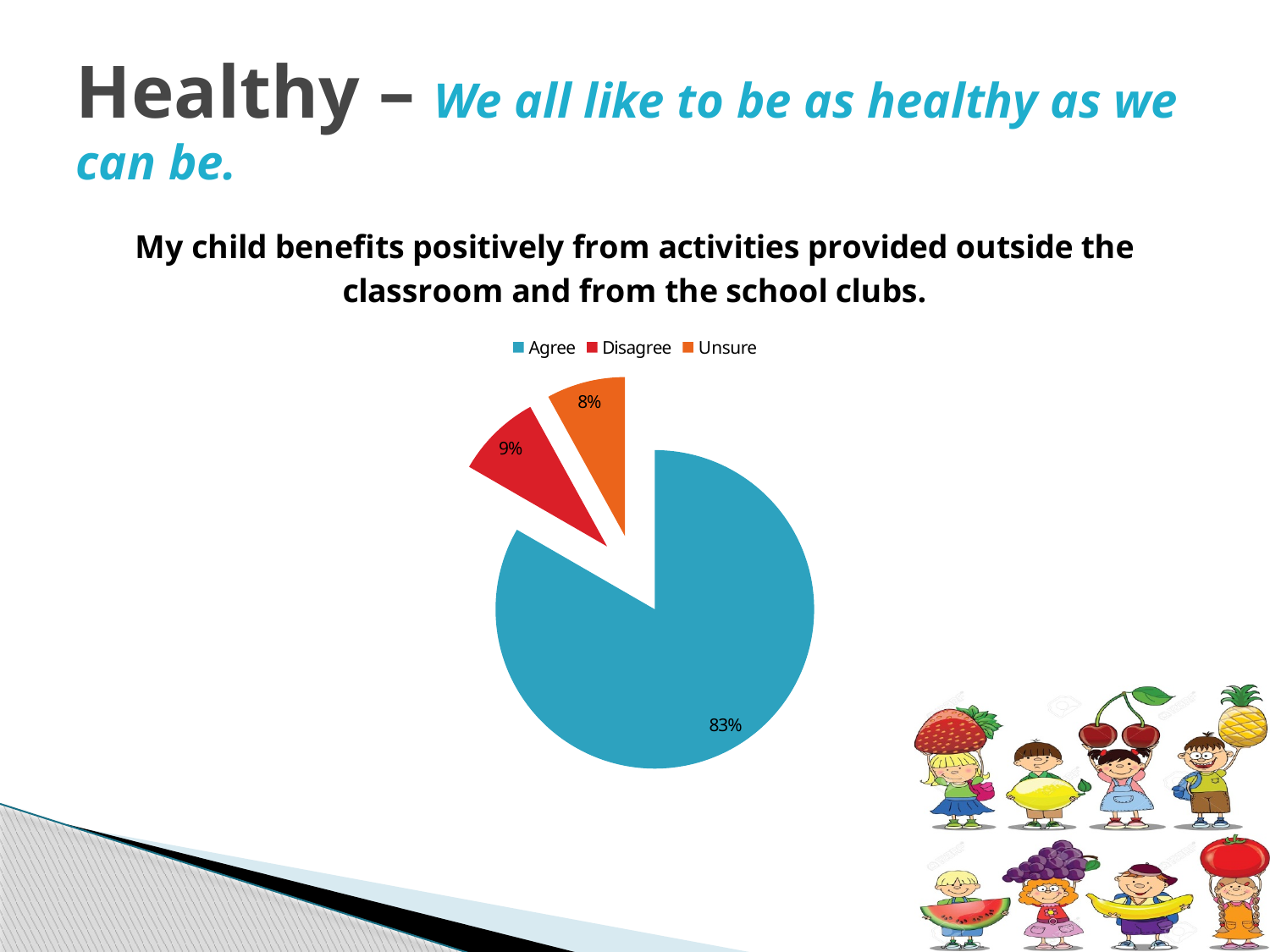
Which is larger, the share for Agree or the share for Unsure? Agree What kind of chart is shown on the slide? pie chart What is the difference in percentage points between Agree and Disagree? 74 How many categories does the pie chart show? 3 What colour is the Agree slice of the pie? blue Which response has the smallest share of the pie? Unsure How many entries does the legend list? 3 What percentage of respondents chose Agree? 83% What percentage of respondents chose Disagree? 9% What is the difference in percentage points between Disagree and Unsure? 1 Which response has the largest share of the pie? Agree What percentage of respondents chose Unsure? 8%